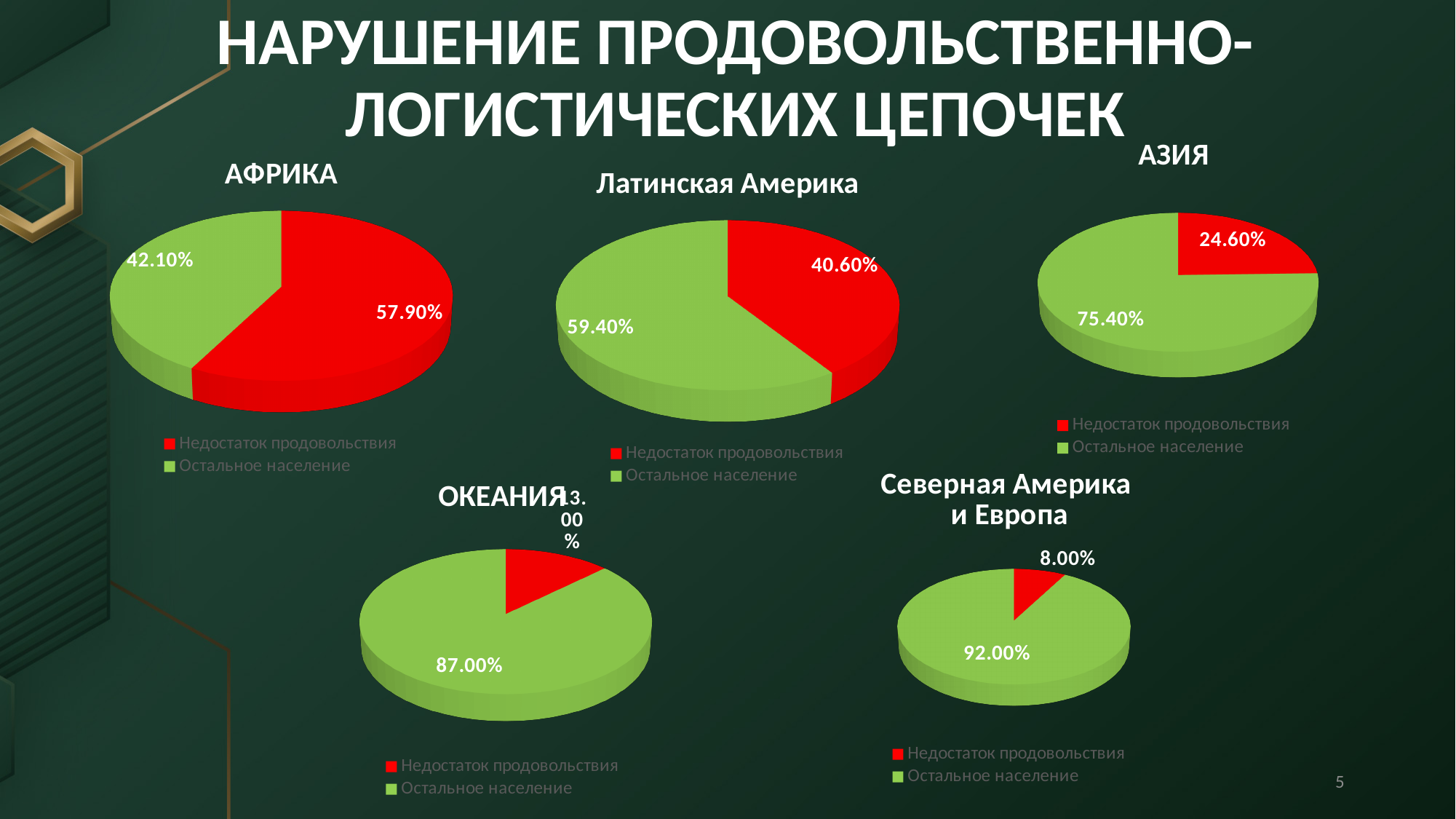
In the АЗИЯ pie chart, what is the value for Остальное население? 75.40% In the ОКЕАНИЯ pie chart, what is the value for Остальное население? 87.00% In the Латинская Америка pie chart, what is the value for Недостаток продовольствия? 40.60% In the АФРИКА pie chart, which slice is larger: Недостаток продовольствия or Остальное население? Недостаток продовольствия How many pie charts are shown on the slide? 5 In the АФРИКА pie chart, what share is labelled for the red slice (Недостаток продовольствия)? 57.90% In the АФРИКА pie chart, what share is labelled for Остальное население? 42.10% What type of chart is used for the Северная Америка и Европа data? Pie chart How many entries does the legend of the АЗИЯ chart list? 2 In the Северная Америка и Европа pie chart, what is the value for Недостаток продовольствия? 8.00% In the АЗИЯ pie chart, what is the difference between the Остальное население and Недостаток продовольствия shares? 50.80% In the Латинская Америка pie chart, what is the difference between the Остальное население and Недостаток продовольствия shares? 18.80%